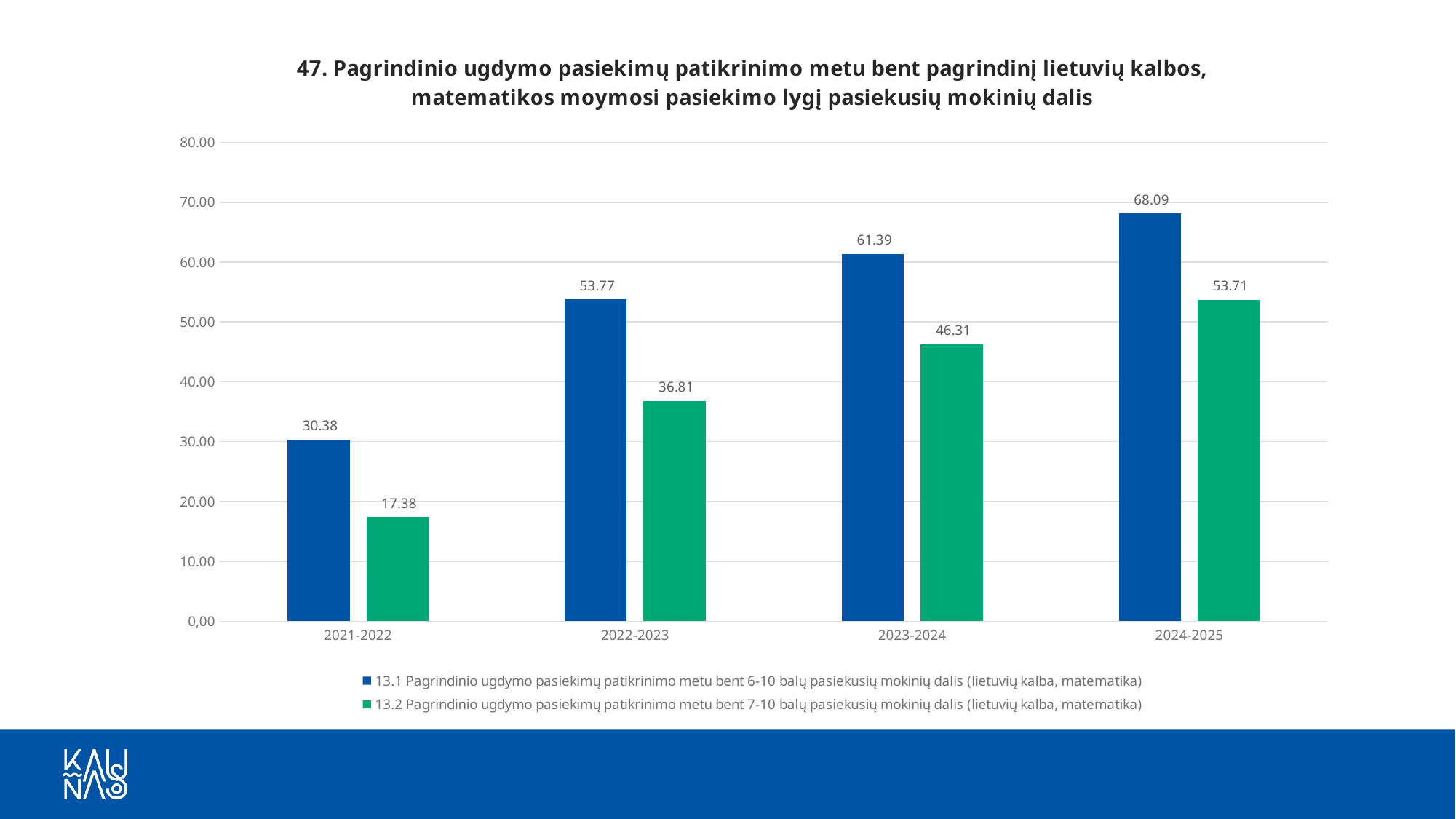
What is the value of series 13.1 (bent 6-10 balų) for 2024-2025? 68.09 What is the value of series 13.2 (bent 7-10 balų) for 2023-2024? 46.31 What is the difference between the 13.1 and 13.2 values for 2022-2023? 16.96 Do the values of series 13.1 rise or fall from 2021-2022 to 2024-2025? rise Is the 13.2 value for 2021-2022 greater or less than 20.00? less What kind of chart is shown on the slide? bar chart Which year has the highest value for series 13.2 (bent 7-10 balų)? 2024-2025 Which is larger: the 13.2 value for 2024-2025 or the 13.1 value for 2022-2023? 13.1 value for 2022-2023 (53.77) What is the value of series 13.1 (bent 6-10 balų) for 2021-2022? 30.38 Which year has the lowest value for series 13.1 (bent 6-10 balų)? 2021-2022 How many school years are shown on the x axis? 4 How many series does the legend list? 2